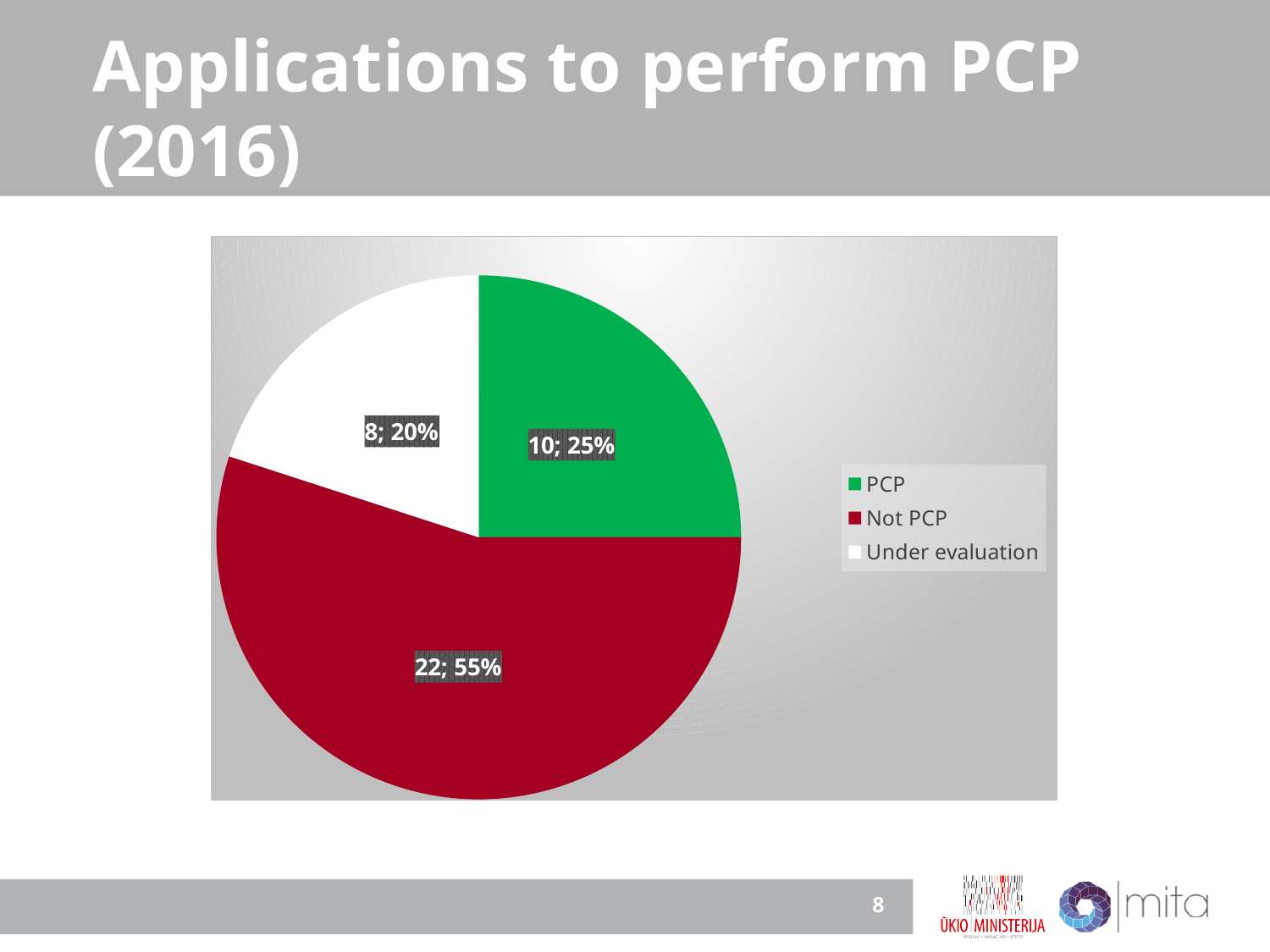
Which is larger, the PCP slice or the Under evaluation slice? PCP What share of the pie does the Under evaluation slice represent? 20% What share of the pie does the Not PCP slice represent? 55% How many applications are Under evaluation? 8 Which category has the smallest slice? Under evaluation How many categories does the legend list? 3 What share of the pie does the PCP slice represent? 25% How many applications are in the PCP category? 10 How many applications are in the Not PCP category? 22 What is the difference between the number of Not PCP applications and PCP applications? 12 Which category has the largest slice? Not PCP What kind of chart is shown on the slide? pie chart